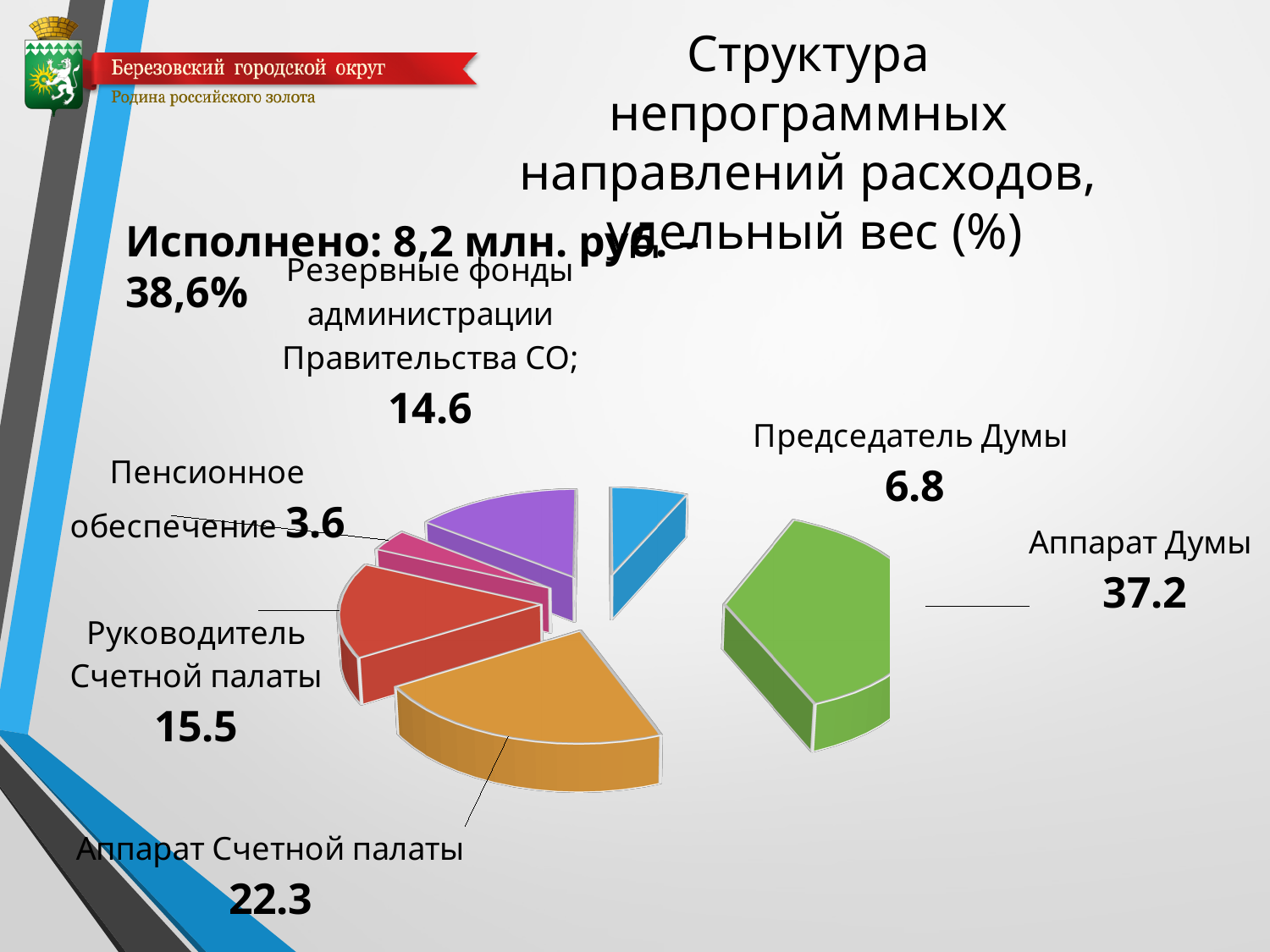
What is the difference between the values for Аппарат Думы and Аппарат Счетной палаты? 14.9 What is the value for Аппарат Думы in the pie chart? 37.2 Which category has the smallest slice in the pie chart? Пенсионное обеспечение What is the value for Председатель Думы in the pie chart? 6.8 What is the difference between the values for Руководитель Счетной палаты and Пенсионное обеспечение? 11.9 What is the title of the chart on the slide? Структура непрограммных направлений расходов, удельный вес (%) Which is larger: Руководитель Счетной палаты or Резервные фонды администрации Правительства СО? Руководитель Счетной палаты What is the value for Аппарат Счетной палаты in the pie chart? 22.3 Which category has the largest slice in the pie chart? Аппарат Думы How many slices does the pie chart have? 6 What is the value for Резервные фонды администрации Правительства СО in the pie chart? 14.6 What kind of chart is shown on the slide? Pie chart